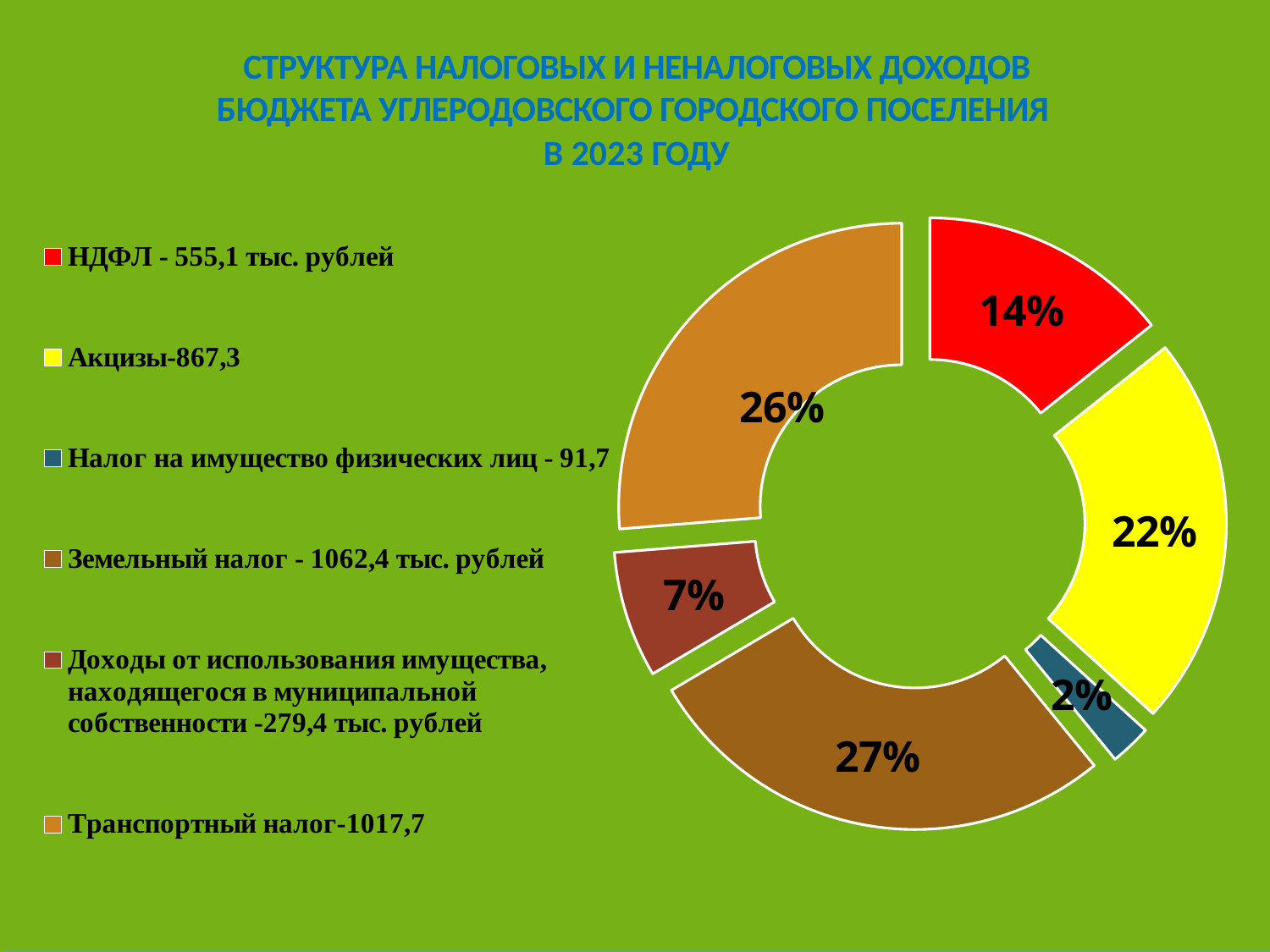
What amount in thousand rubles does the legend give for Земельный налог? 1062,4 тыс. рублей Which category has the smallest share of the chart? Налог на имущество физических лиц What percentage is shown for the Акцизы slice? 22% What percentage is shown for the Транспортный налог slice? 26% What colour is the Акцизы slice? Yellow Which slice is larger: Акцизы or НДФЛ? Акцизы What is the difference in percentage points between the Земельный налог slice and the Транспортный налог slice? 1 percentage point Which category has the largest share of the chart? Земельный налог How many slices does the chart have? 6 Which year does the chart title refer to? 2023 What share of the doughnut chart does НДФЛ represent? 14% What kind of chart is shown on the slide? Doughnut (pie) chart